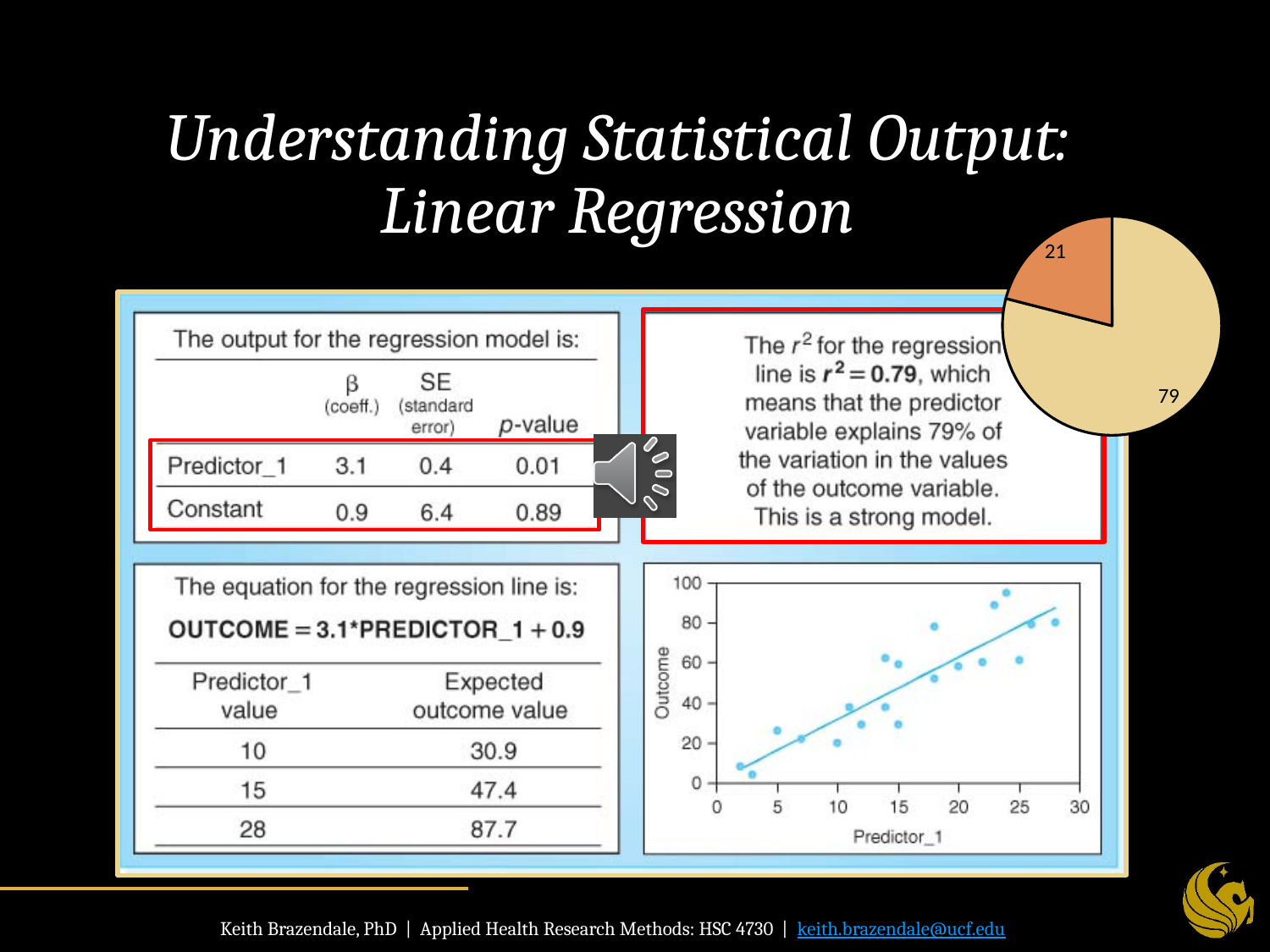
In the scatter plot at the bottom right, what is the label on the x axis? Predictor_1 In the pie chart, what is the difference between the two slice values, 79 and 21? 58 In the pie chart, what is the total of the two slice values? 100 How many slices does the pie chart in the top right have? 2 In the pie chart, what is the value shown on the larger (yellow) slice? 79 In the pie chart, what is the smallest value shown? 21 In the pie chart, what is the value shown on the smaller (orange) slice? 21 In the scatter plot at the bottom right, do the Outcome values generally rise or fall as Predictor_1 increases? rise In the pie chart, what is the largest value shown? 79 What kind of chart is shown in the bottom right of the slide? scatter plot What kind of chart is shown in the top right corner of the slide? pie chart In the pie chart, which slice is larger, the orange one or the yellow one? the yellow one